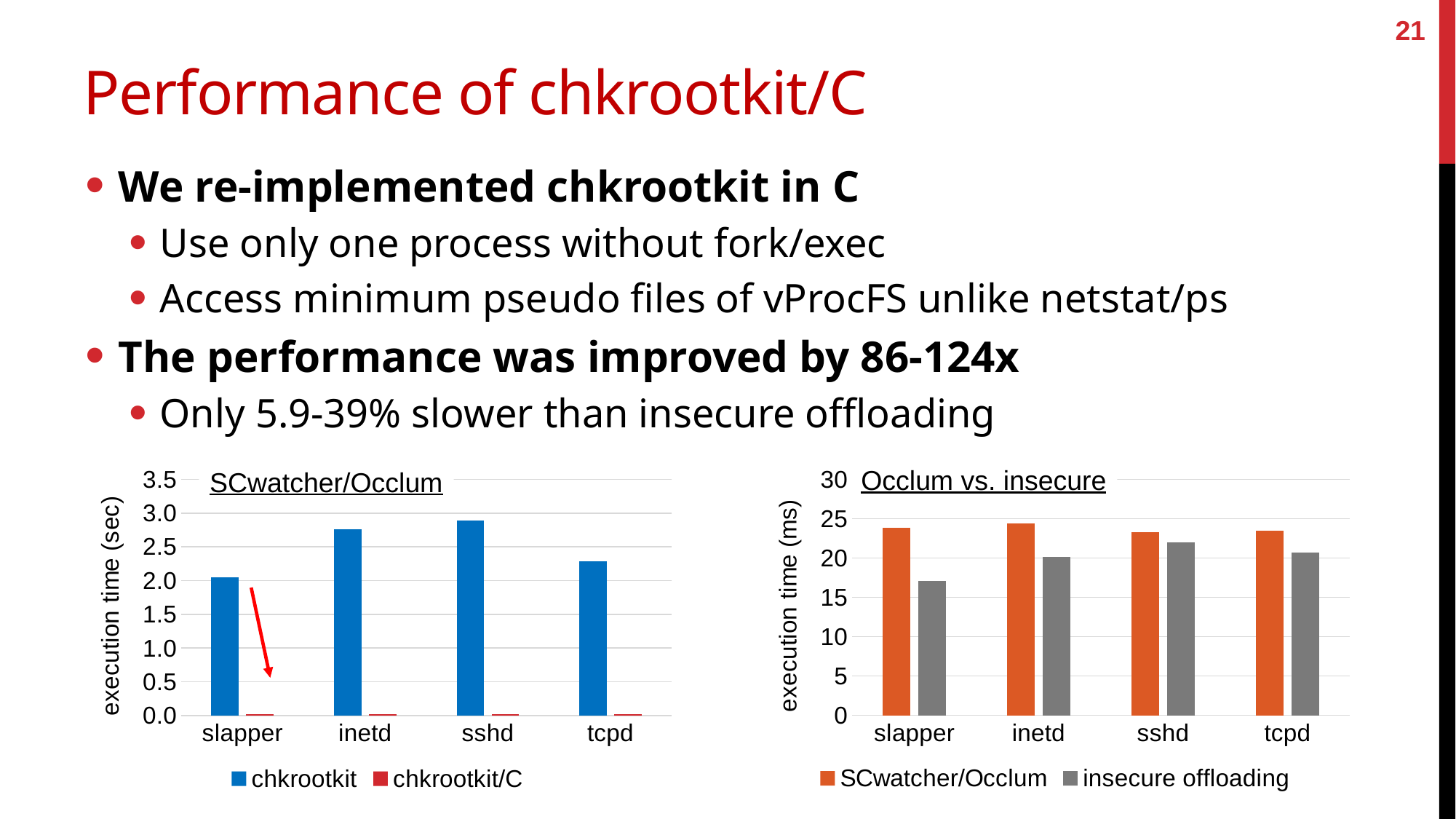
In the SCwatcher/Occlum chart, which series is larger for slapper, chkrootkit or chkrootkit/C? chkrootkit In the SCwatcher/Occlum chart, how many series does the legend list? 2 In the SCwatcher/Occlum chart, which category has the highest chkrootkit execution time? sshd In the SCwatcher/Occlum chart, which category has the lowest chkrootkit execution time? slapper In the Occlum vs. insecure chart, is the insecure offloading value for slapper greater or less than 20? less In the SCwatcher/Occlum chart, is the chkrootkit value for inetd greater or less than 2.5? greater In the Occlum vs. insecure chart, which category has the lowest insecure offloading execution time? slapper In the SCwatcher/Occlum chart, what kind of chart is shown? bar chart In the SCwatcher/Occlum chart, how many categories are shown on the x axis? 4 In the Occlum vs. insecure chart, which series is larger for sshd, SCwatcher/Occlum or insecure offloading? SCwatcher/Occlum In the SCwatcher/Occlum chart, is the chkrootkit value for tcpd greater or less than 2.5? less In the Occlum vs. insecure chart, what is the y-axis label? execution time (ms)